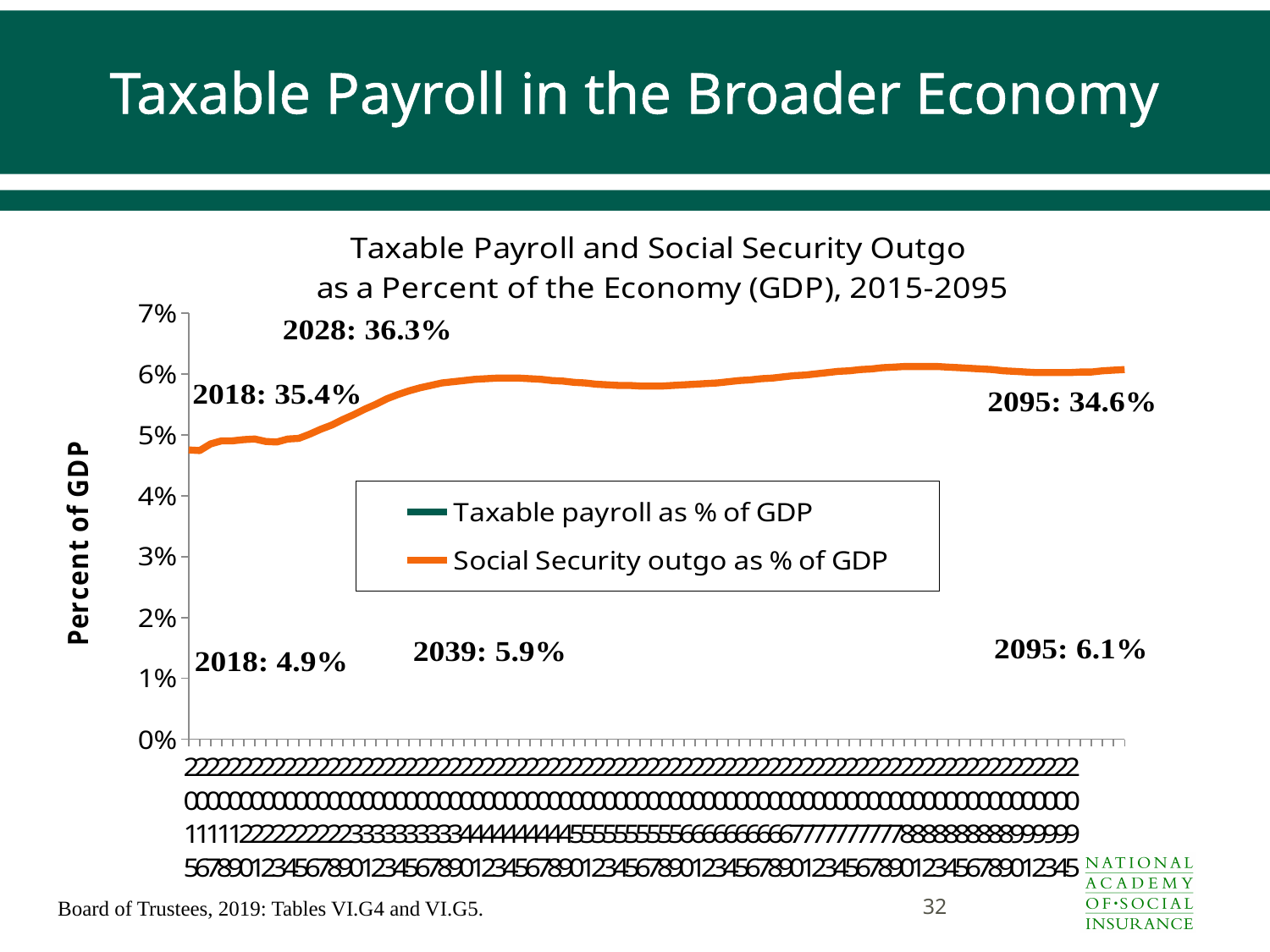
Is the Social Security outgo as % of GDP line greater or less than 5% around the year 2060? greater According to the annotation, what is Social Security outgo as a percent of GDP in 2039? 5.9% According to the annotation, what is Social Security outgo as a percent of GDP projected to be in 2095? 6.1% By how many percentage points does Social Security outgo as a percent of GDP rise from 2018 (4.9%) to 2095 (6.1%)? 1.2 percentage points What type of chart is shown on the slide? line chart Which is larger: taxable payroll as a percent of GDP in 2028 or in 2095? 2028 According to the annotation, what was taxable payroll as a percent of GDP in 2028? 36.3% According to the annotation, what was Social Security outgo as a percent of GDP in 2018? 4.9% According to the annotation, what is taxable payroll as a percent of GDP projected to be in 2095? 34.6% Does the Social Security outgo as % of GDP line generally rise or fall from 2015 to 2095? rise How many series does the legend list? 2 What is the label on the vertical axis of the chart? Percent of GDP